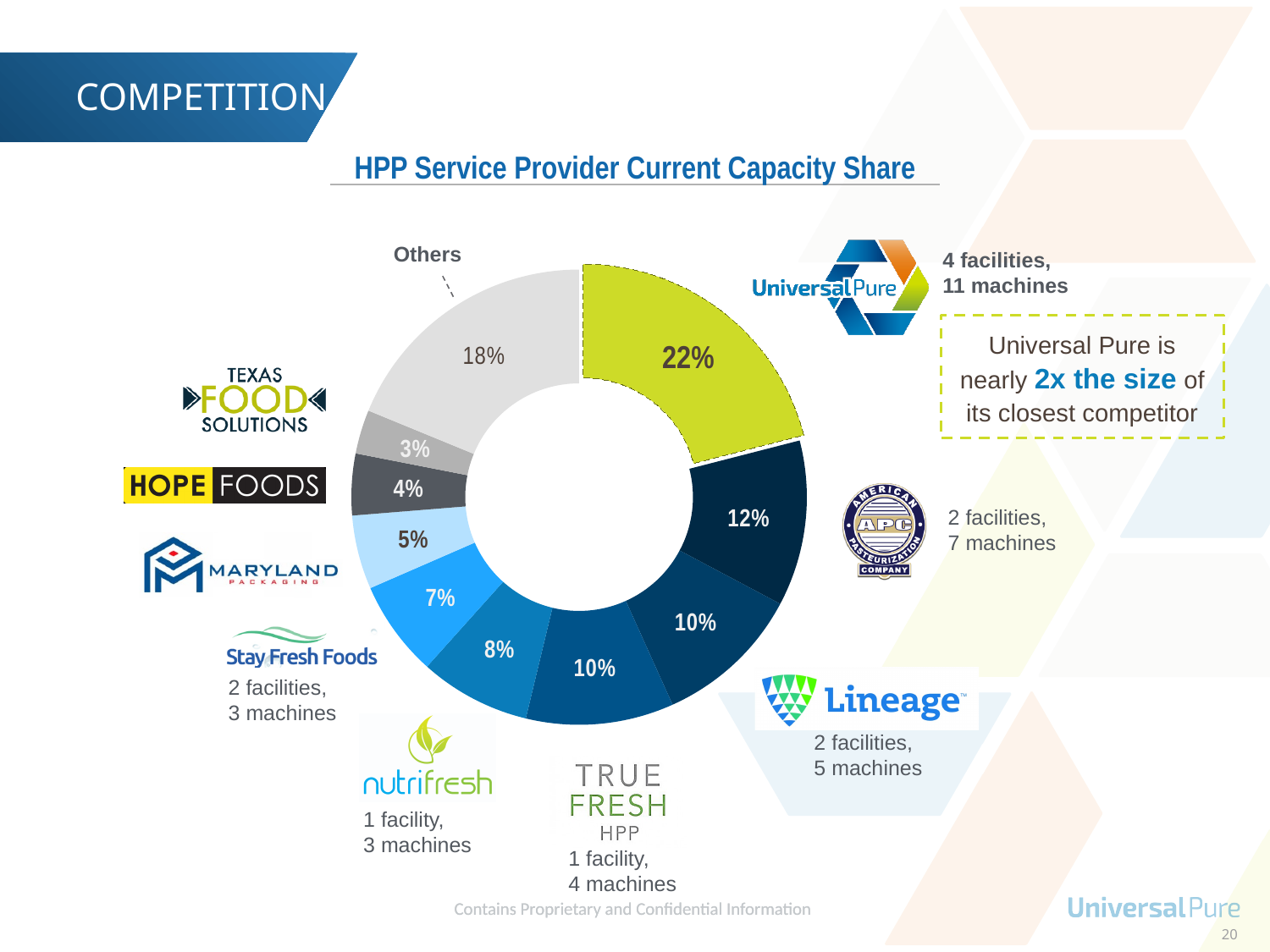
Which provider has the largest capacity share in the chart? Universal Pure What capacity share is shown for the Others slice? 18% What is the difference in percentage points between the Universal Pure slice (22%) and the APC slice (12%)? 10 percentage points What is the difference in percentage points between the Others slice (18%) and the Universal Pure slice (22%)? 4 percentage points Which is larger, the Universal Pure slice or the Others slice? Universal Pure What capacity share does the Universal Pure slice hold? 22% What is the title of the chart? HPP Service Provider Current Capacity Share What is the smallest percentage shown on any slice of the chart? 3% How many slices does the donut chart have? 10 What kind of chart is shown on the slide? Pie (donut) chart What capacity share is shown for the slice next to the American Pasteurization Company (APC) logo? 12% What colour is the Universal Pure slice in the chart? Yellow-green